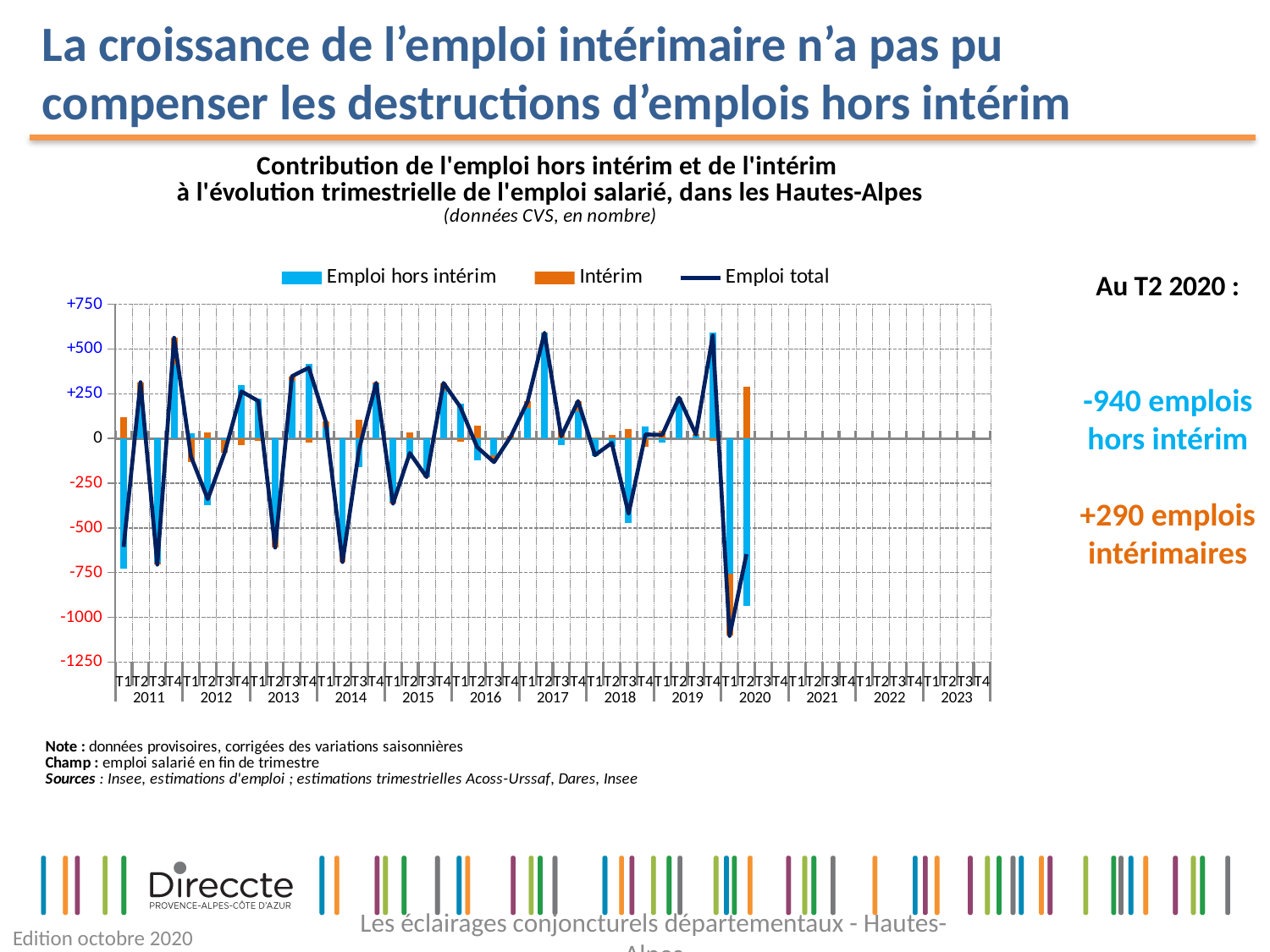
What is the value for Emploi hors intérim at T2 2020? -940 How many years are labelled on the x axis? 13 What colour represents the Intérim series in the legend? Orange What kind of chart is shown on the slide? Combined bar and line chart Is the value of Emploi total at T1 2020 greater or less than -1000? less What is the total of Emploi hors intérim and Intérim at T2 2020? -650 What is the difference between the Intérim value and the Emploi hors intérim value at T2 2020? 1230 At T2 2020, which is larger: Emploi hors intérim or Intérim? Intérim How many series does the chart legend list? 3 What is the value for Intérim at T2 2020? +290 Is the value of Emploi total at T1 2017 greater or less than +500? less In which quarter does the Emploi total line reach its lowest point? T1 2020